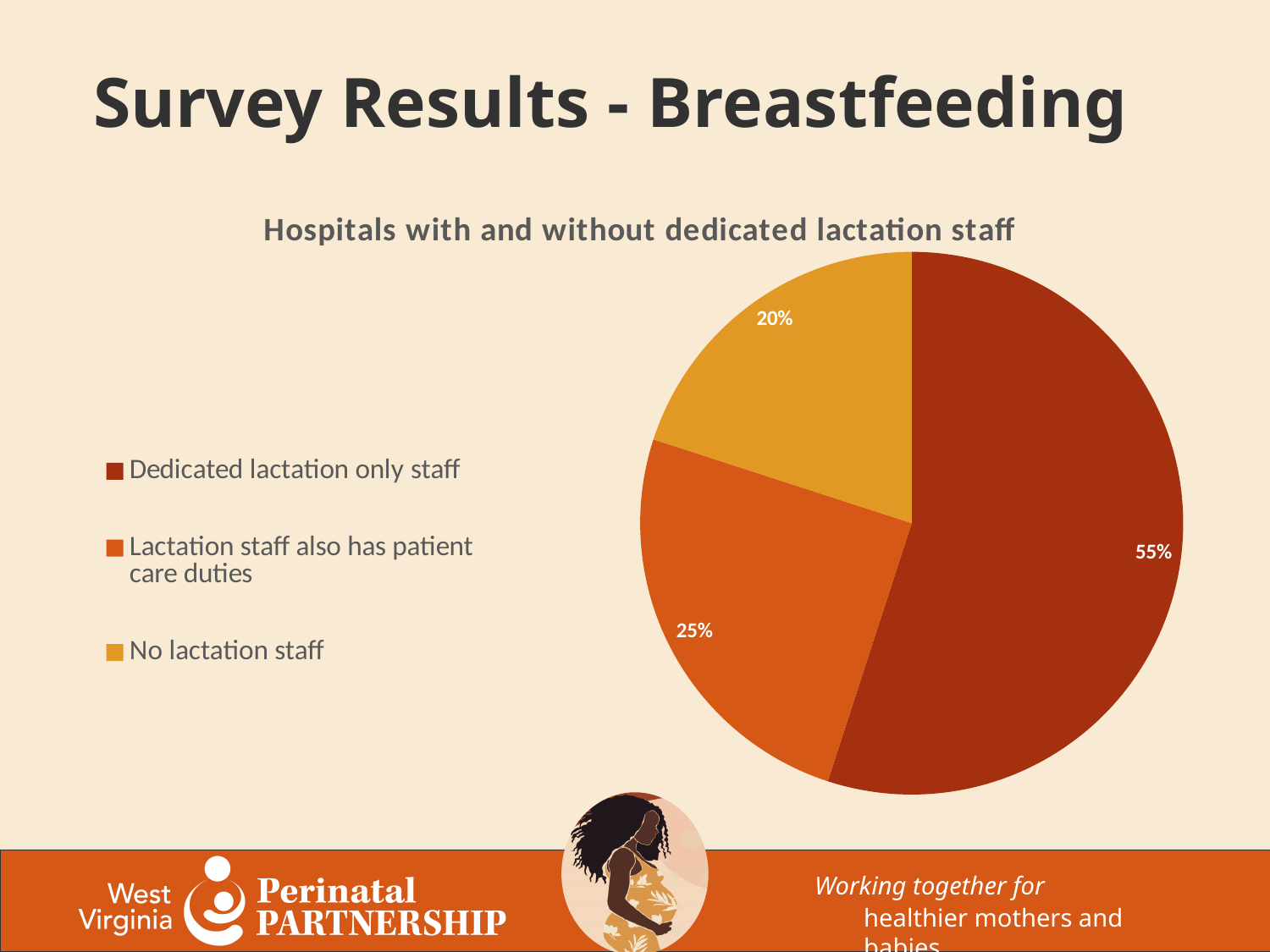
What type of chart is shown on the slide? pie chart How many categories does the pie chart show? 3 What percentage of hospitals have lactation staff that also has patient care duties? 25% Which is larger: the share for lactation staff also has patient care duties or the share for no lactation staff? Lactation staff also has patient care duties What percentage of hospitals have no lactation staff? 20% Which legend entry is shown in the lightest orange colour? No lactation staff What is the difference between the share for dedicated lactation only staff and the share for no lactation staff? 35% Which category has the largest share of the pie? Dedicated lactation only staff What percentage of hospitals have dedicated lactation only staff? 55% What is the difference between the share for lactation staff also has patient care duties and the share for no lactation staff? 5% Which category has the smallest share of the pie? No lactation staff What is the chart's title? Hospitals with and without dedicated lactation staff